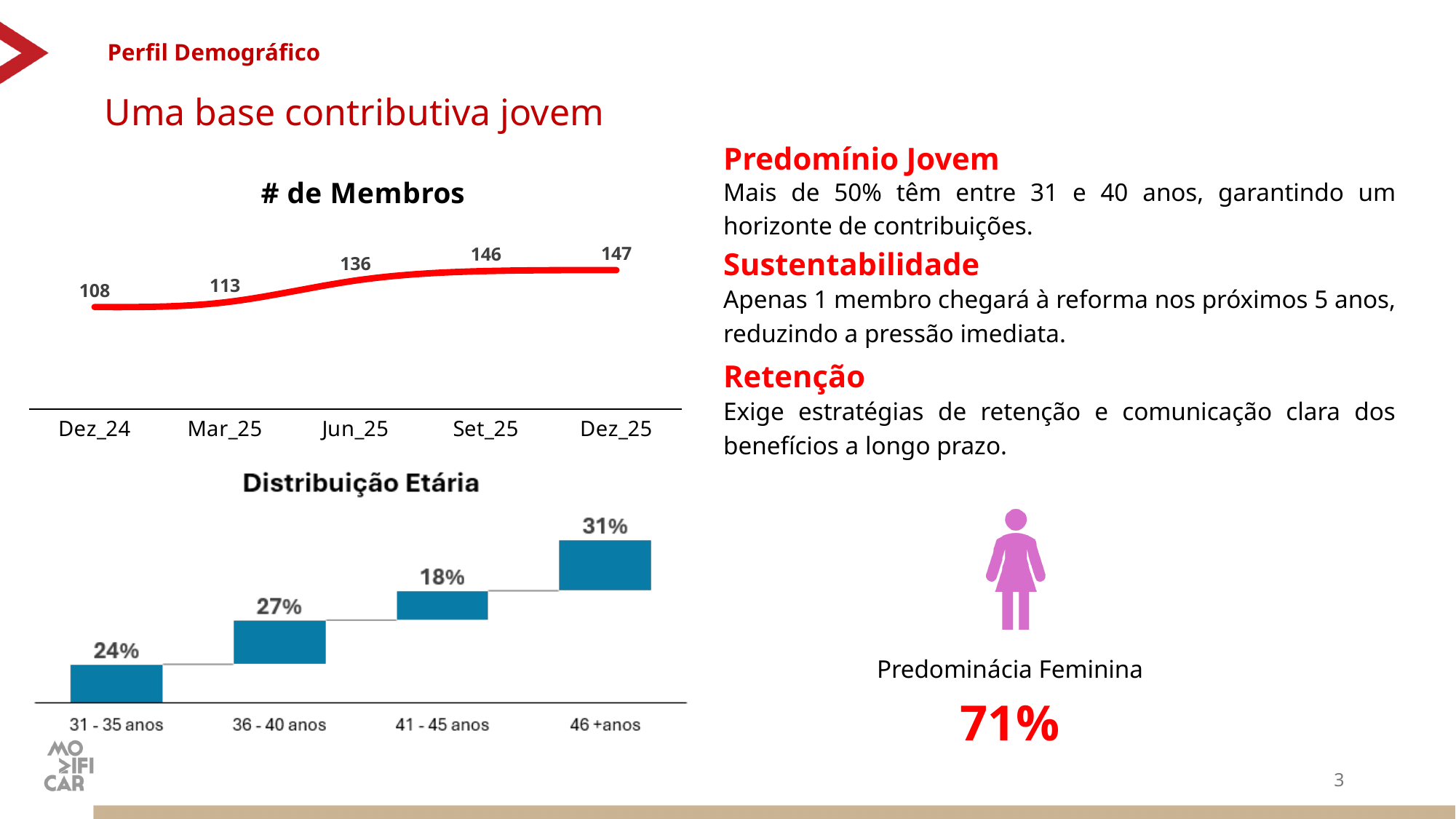
What kind of chart is 'Distribuição Etária'? bar chart In the '# de Membros' chart, do the values rise or fall from Dez_24 to Dez_25? rise In the 'Distribuição Etária' chart, which age group has the highest value? 46 +anos In the 'Distribuição Etária' chart, what is the value for 36 - 40 anos? 27% In the '# de Membros' chart, what is the difference between the values for Dez_25 and Dez_24? 39 In the 'Distribuição Etária' chart, what is the difference between the values for 46 +anos and 31 - 35 anos? 7% In the '# de Membros' chart, which period has the highest value? Dez_25 In the 'Distribuição Etária' chart, which age group has the lowest value? 41 - 45 anos In the '# de Membros' chart, what is the value for Dez_24? 108 What kind of chart is '# de Membros'? line chart How many data points are plotted in the '# de Membros' chart? 5 In the '# de Membros' chart, what is the value for Jun_25? 136